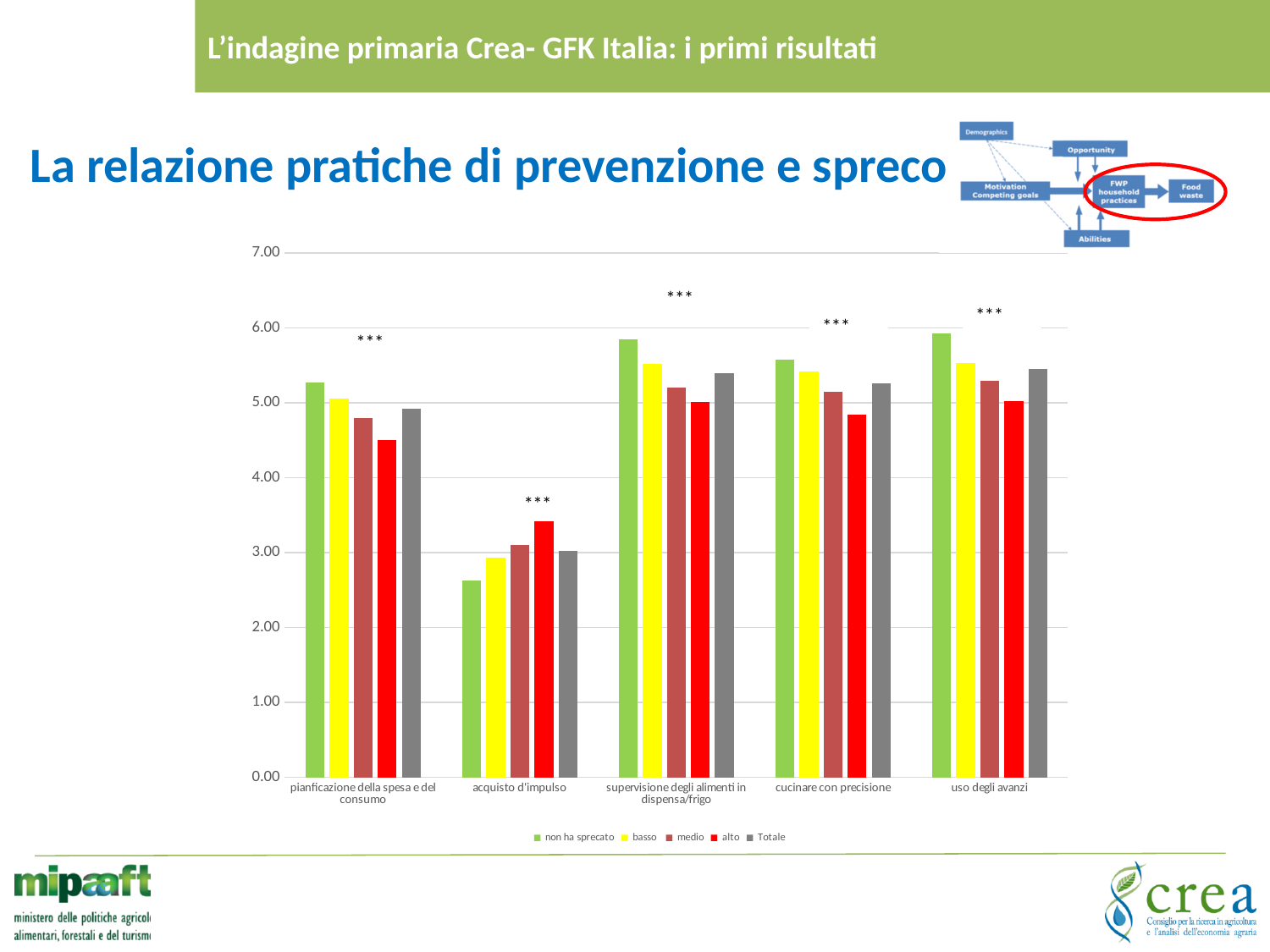
Is the value for 'alto' in the category 'acquisto d'impulso' greater or less than 3.00? greater In the category 'acquisto d'impulso', which is larger: the value for 'alto' or the value for 'non ha sprecato'? alto What colour represents the 'Totale' series in the chart? grey In the category 'pianficazione della spesa e del consumo', which is larger: the value for 'non ha sprecato' or the value for 'alto'? non ha sprecato Is the value for 'non ha sprecato' in the category 'acquisto d'impulso' greater or less than 3.00? less Which category has the lowest value for the Totale series? acquisto d'impulso What kind of chart is shown on the slide? bar chart Is the value for 'Totale' in the category 'uso degli avanzi' greater or less than 5.00? greater How many series does the chart legend list? 5 How many categories are shown along the x axis of the chart? 5 Which series has the highest value in the category 'cucinare con precisione'? non ha sprecato